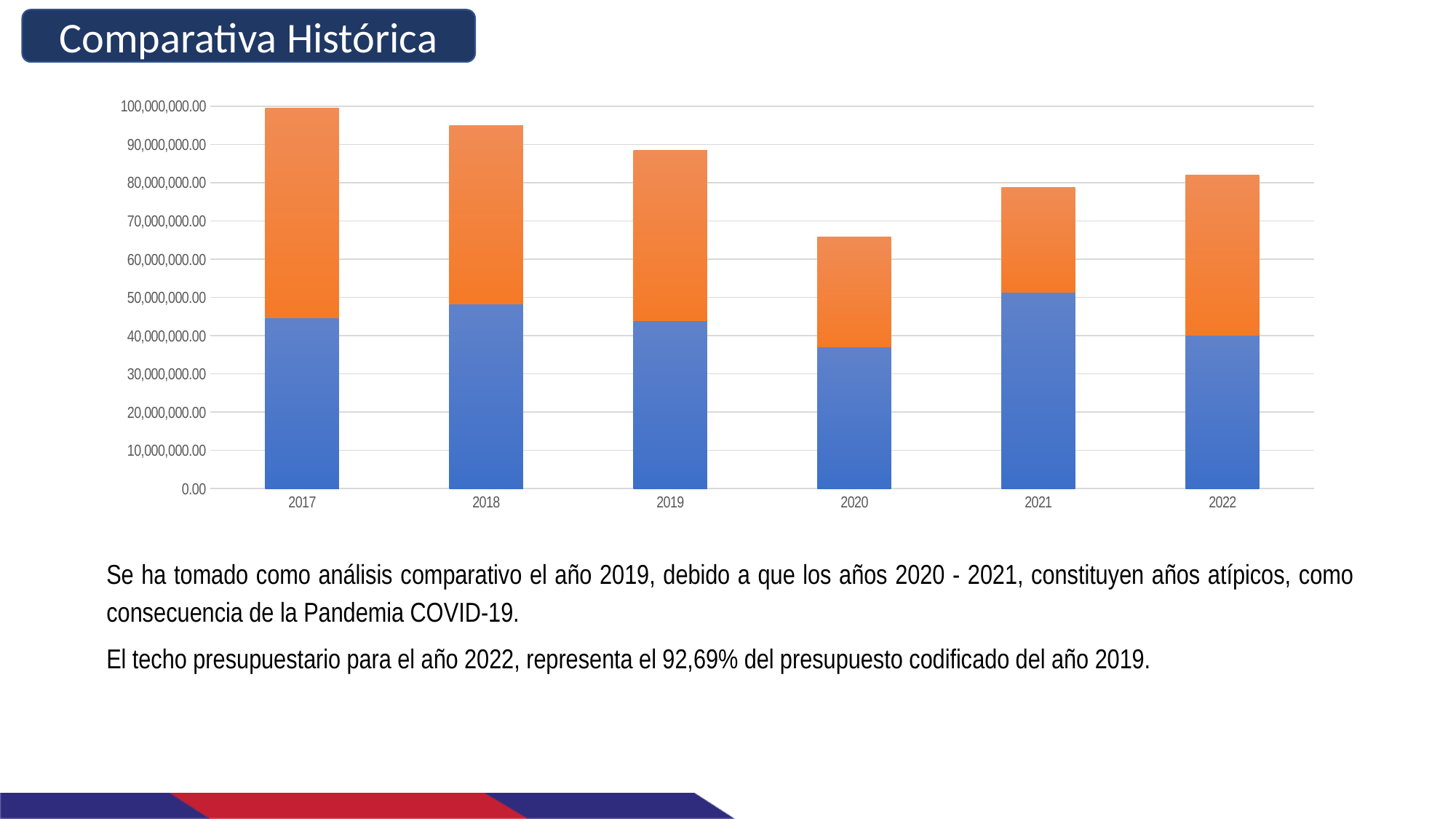
What is the title shown at the top of the slide? Comparativa Histórica Which year has the larger blue segment, 2020 or 2021? 2021 Do the total bar values rise or fall from 2017 to 2020? fall What kind of chart is shown on the slide? Stacked bar chart Which year has the highest total bar in the chart? 2017 Is the total value for 2019 greater or less than 80,000,000.00? greater How many years are shown on the x axis of the chart? 6 Is the total value for 2020 greater or less than 70,000,000.00? less Is the blue segment for 2020 greater or less than 40,000,000.00? less Which year has the larger total bar, 2018 or 2019? 2018 Which year has the lowest total bar in the chart? 2020